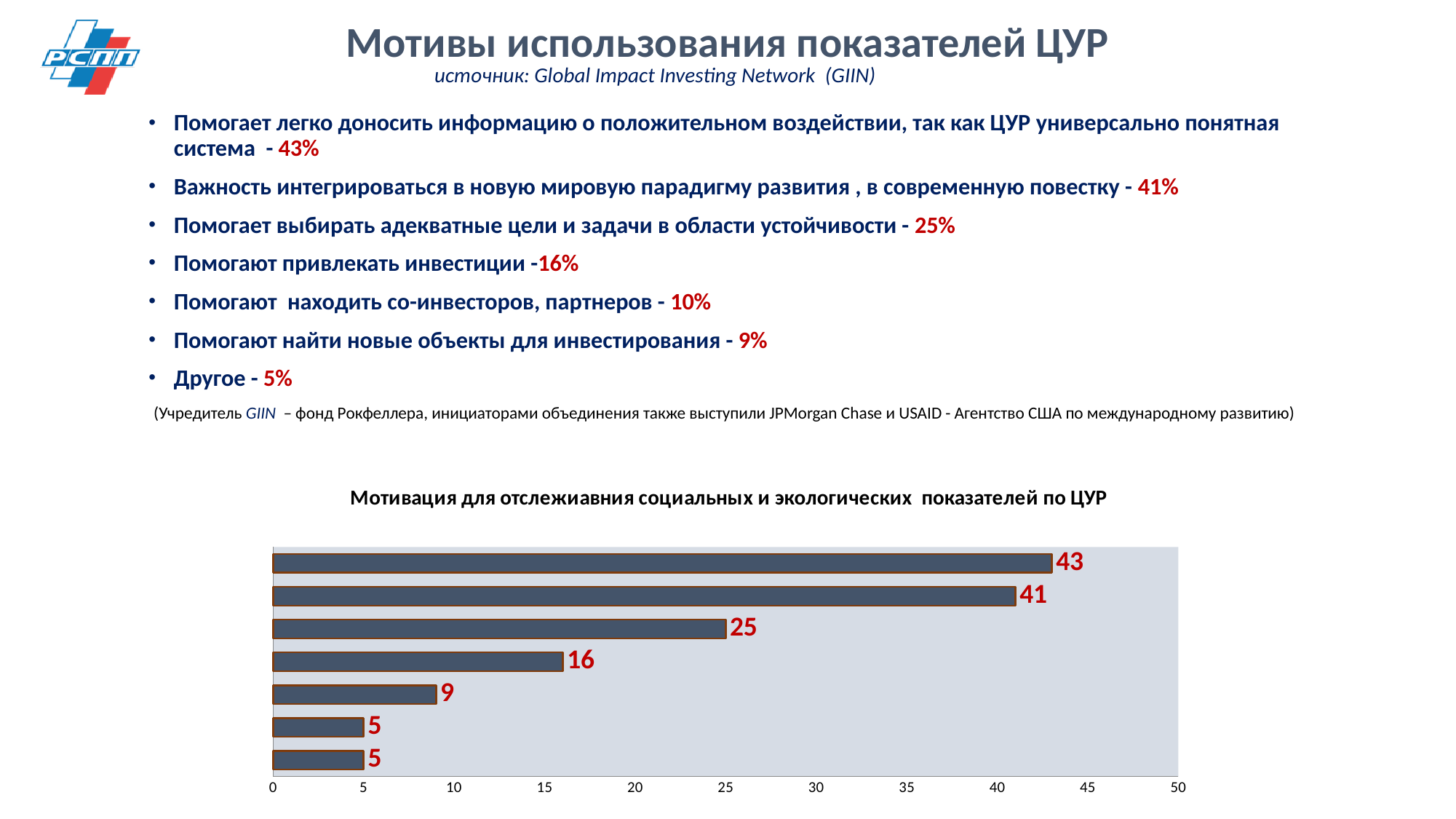
How many bars are plotted in the chart? 7 What is the lowest value shown in the chart? 5 What is the value of the third bar from the top in the chart? 25 What is the value of the bottom bar in the chart? 5 What is the highest value shown in the chart? 43 What is the value of the fourth bar from the top in the chart? 16 What is the title of the chart on the slide? Мотивация для отслежиавния социальных и экологических показателей по ЦУР What is the maximum value shown on the x axis of the chart? 50 What type of chart is shown on the slide? bar chart What is the value of the top bar in the chart? 43 What is the difference between the top bar and the second bar from the top in the chart? 2 What is the value of the second bar from the top in the chart? 41